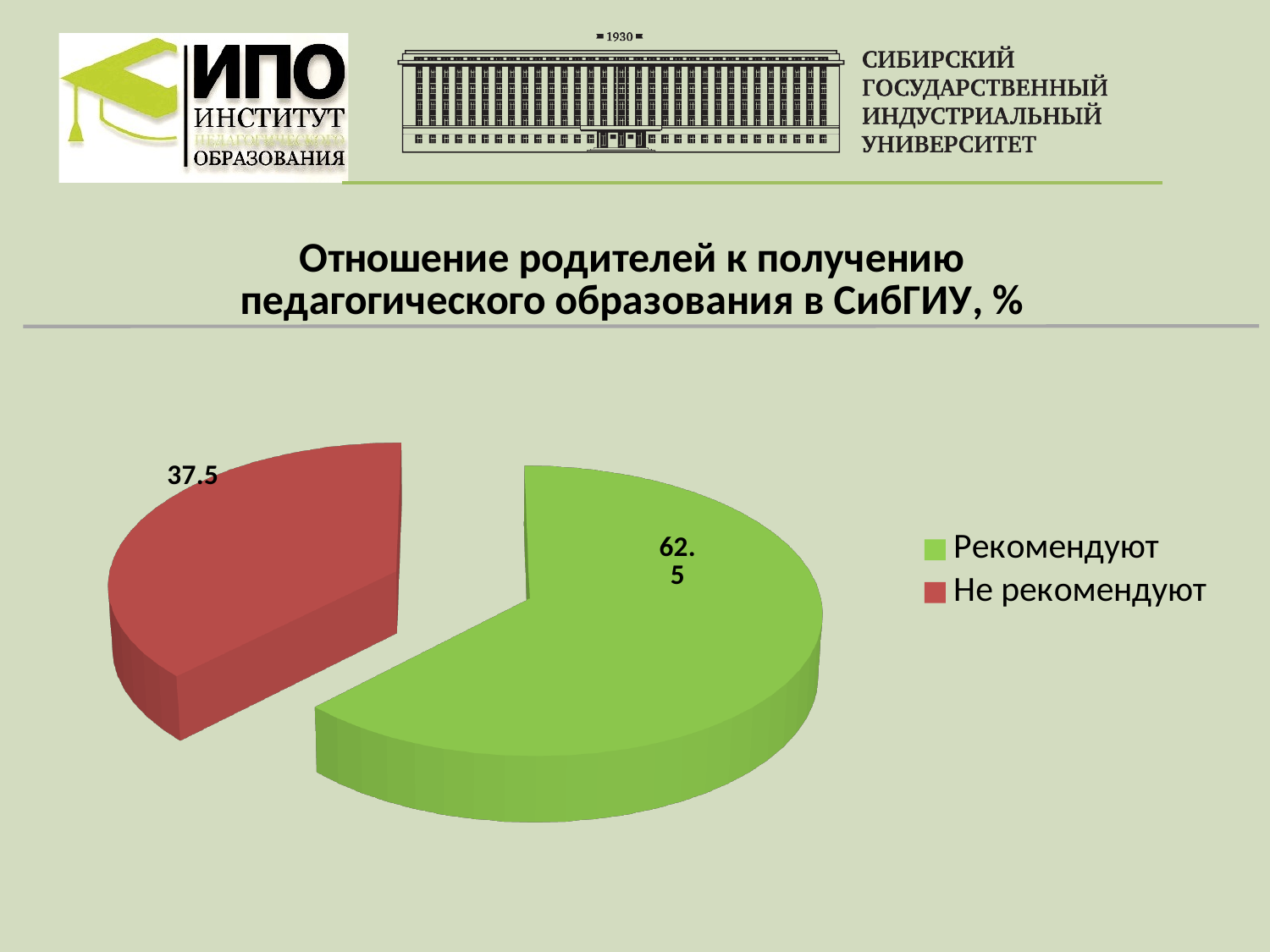
What is the title of the chart? Отношение родителей к получению педагогического образования в СибГИУ, % Which category has the largest share of the pie? Рекомендуют What is the difference between the values for Рекомендуют and Не рекомендуют? 25 What colour is the Не рекомендуют slice? red How many entries does the legend list? 2 Which category has the smallest share of the pie? Не рекомендуют What share of the pie does the Рекомендуют slice represent? 62.5% What is the value for Рекомендуют? 62.5 What kind of chart is shown on the slide? pie chart How many slices does the pie chart have? 2 Which is larger, the value for Рекомендуют or the value for Не рекомендуют? Рекомендуют What is the value for Не рекомендуют? 37.5